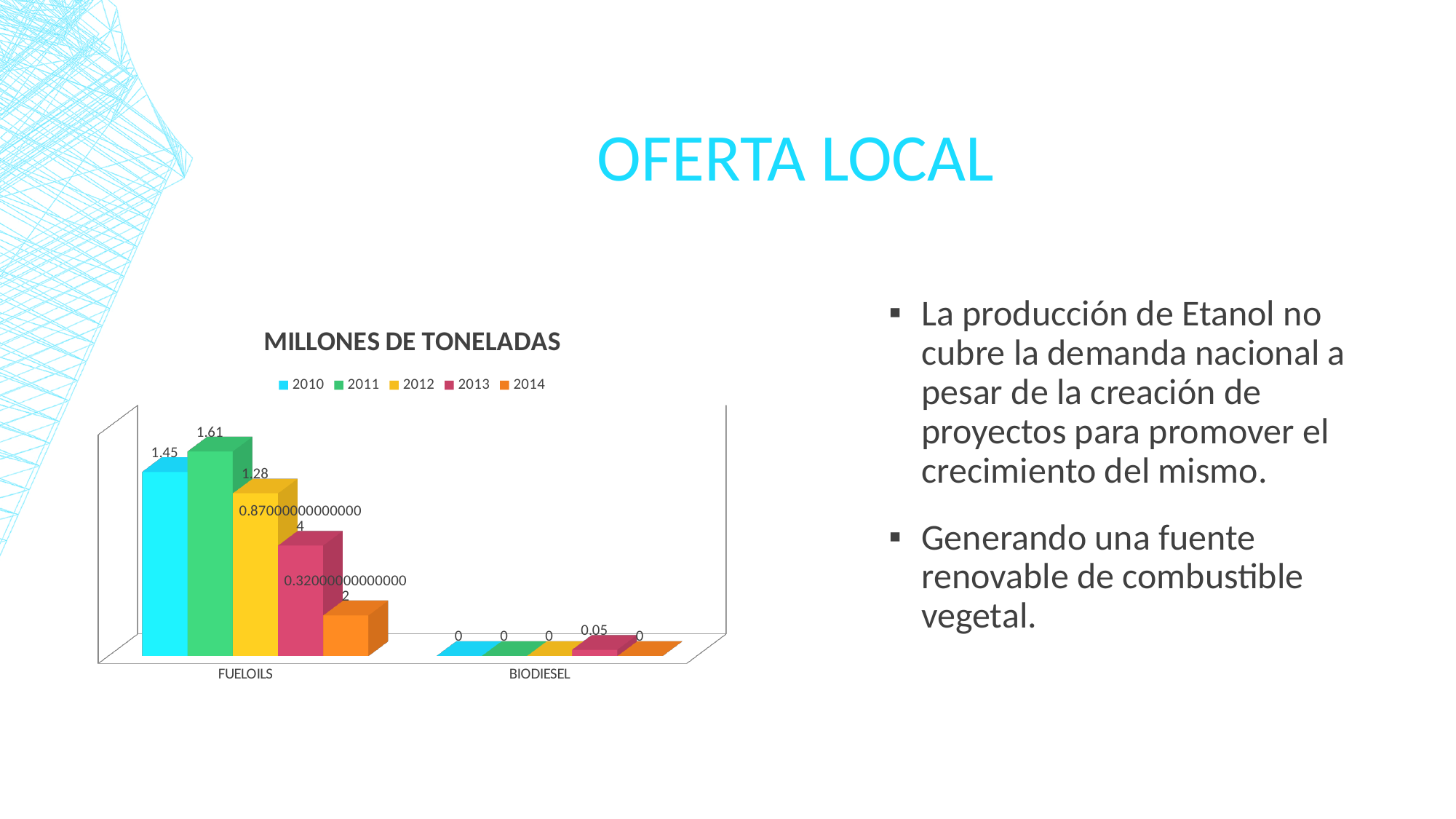
What is the value for BIODIESEL in 2010? 0 How many categories are shown on the x axis of the chart? 2 What is the difference between the FUELOILS values for 2011 and 2010? 0.16 What is the value for FUELOILS in 2012? 1.28 What is the value for FUELOILS in 2010? 1.45 What is the value for FUELOILS in 2011? 1.61 How many series does the chart legend list? 5 Which is larger, the FUELOILS value for 2013 or for 2014? 2013 Which year has the highest value for FUELOILS? 2011 What type of chart is shown on the slide? bar chart What is the value for BIODIESEL in 2013? 0.05 What is the title of the chart? MILLONES DE TONELADAS